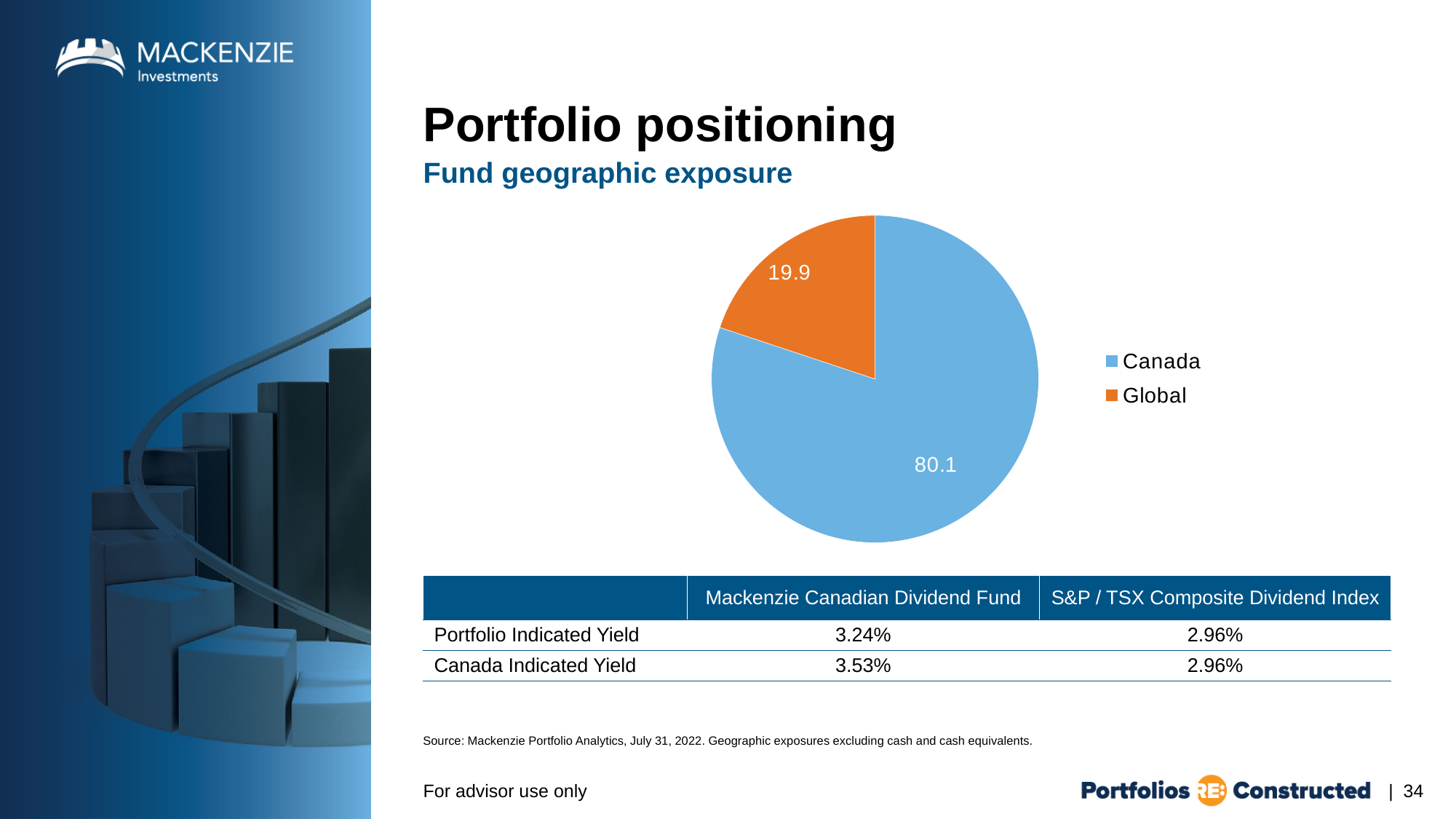
How many entries does the legend of the pie chart list? 2 What is the total of the two values shown in the pie chart? 100 How many slices does the pie chart have? 2 Which slice of the pie chart is the largest? Canada What is the value for Global in the pie chart? 19.9 What colour is the Global slice in the pie chart? orange What is the value for Canada in the pie chart? 80.1 What kind of chart is shown on the slide? pie chart Which slice of the pie chart is the smallest? Global Which is larger in the pie chart, Canada or Global? Canada What colour is the Canada slice in the pie chart? blue What is the difference between the Canada and Global values in the pie chart? 60.2